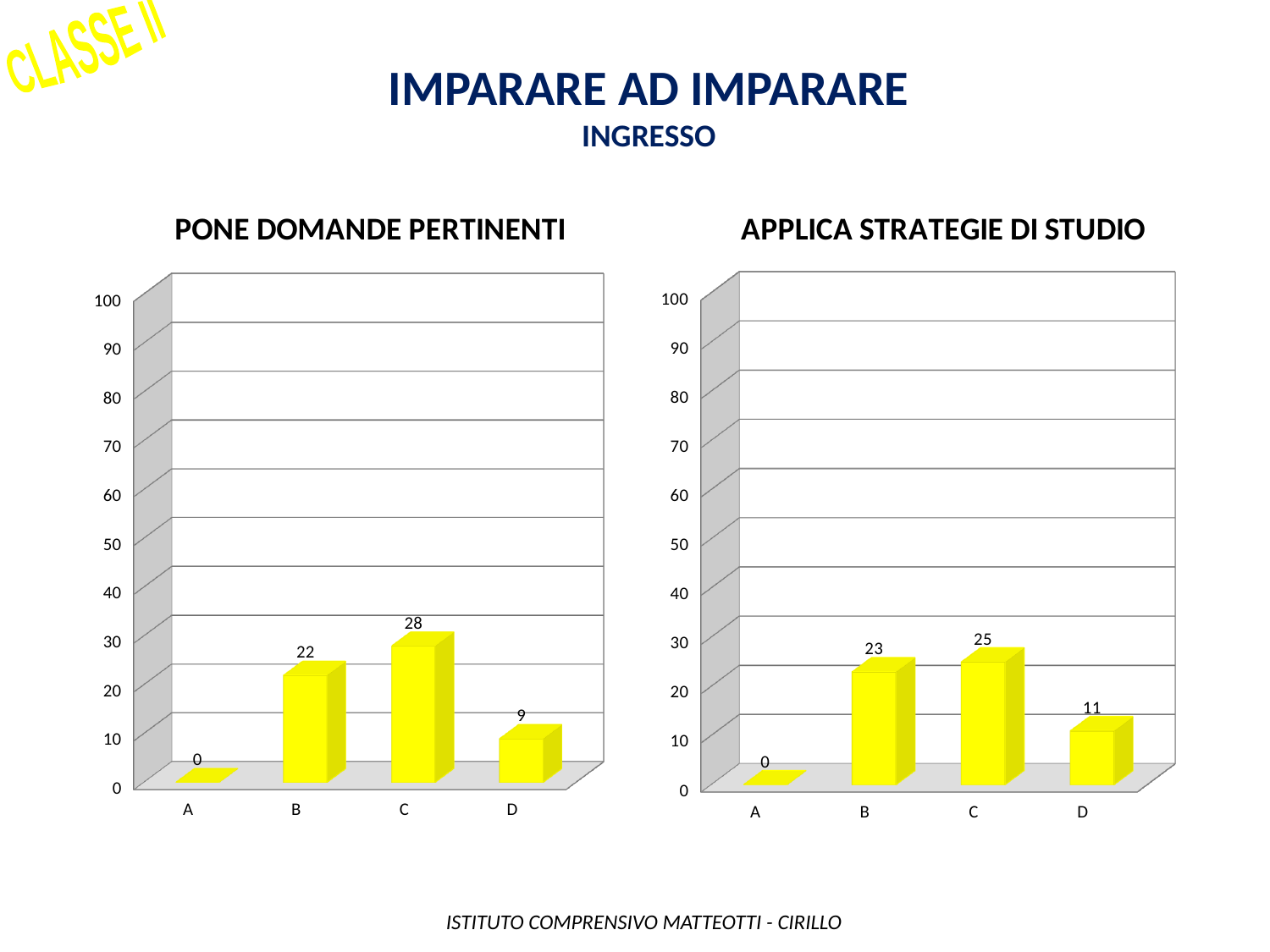
In the 'PONE DOMANDE PERTINENTI' chart, what is the value for category A? 0 In the 'APPLICA STRATEGIE DI STUDIO' chart, what is the difference between the values for B and D? 12 In the 'PONE DOMANDE PERTINENTI' chart, is the value for D greater or less than 20? less How many categories are shown in the 'APPLICA STRATEGIE DI STUDIO' chart? 4 What kind of chart is the 'PONE DOMANDE PERTINENTI' chart? bar chart What is the title of the chart on the right side of the slide? APPLICA STRATEGIE DI STUDIO In the 'APPLICA STRATEGIE DI STUDIO' chart, what is the value for category D? 11 In the 'PONE DOMANDE PERTINENTI' chart, what is the difference between the values for C and B? 6 In the 'PONE DOMANDE PERTINENTI' chart, which category has the highest value? C In the 'APPLICA STRATEGIE DI STUDIO' chart, which category has the lowest value? A In the 'APPLICA STRATEGIE DI STUDIO' chart, which is larger, the value for B or the value for D? B In the 'PONE DOMANDE PERTINENTI' chart, what is the value for category C? 28